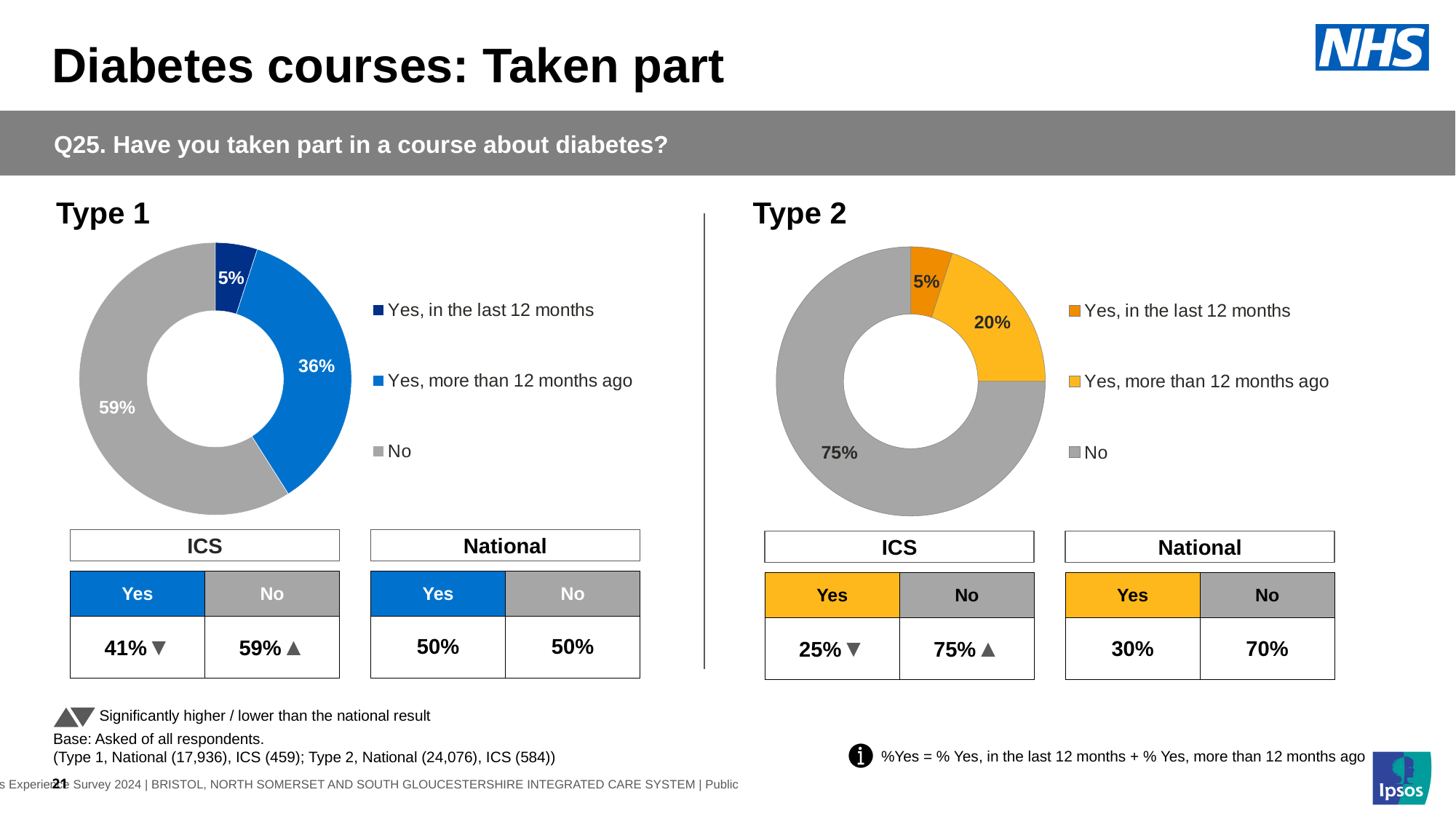
In the Type 2 chart, what is the combined share of the two 'Yes' categories? 25% How many categories does the Type 2 chart show? 3 In the Type 1 chart, what is the difference between the 'No' share and the 'Yes, more than 12 months ago' share? 23 percentage points How many entries does the legend of the Type 1 chart list? 3 In the Type 2 chart, what percentage answered 'Yes, more than 12 months ago'? 20% In the Type 2 chart, which category has the largest share? No In the Type 1 chart, what percentage answered 'Yes, in the last 12 months'? 5% In the Type 1 chart, what percentage of respondents answered 'No'? 59% In the Type 1 chart, which category has the smallest share? Yes, in the last 12 months Which is larger: the 'Yes, more than 12 months ago' share in the Type 1 chart or in the Type 2 chart? Type 1 What kind of chart is used for Type 1? Doughnut (pie) chart In the Type 2 chart, what colour represents 'No'? Grey